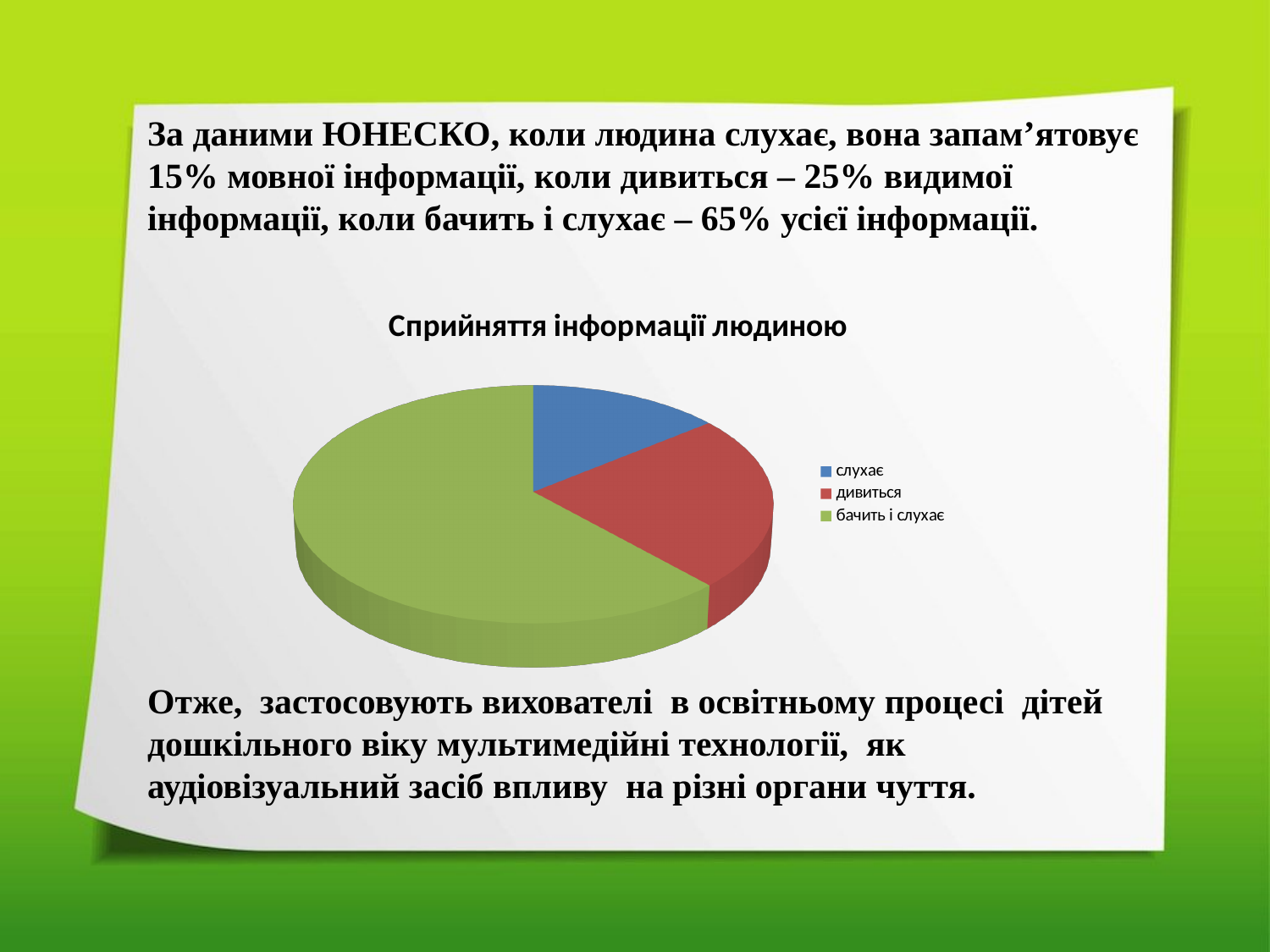
How many slices does the pie chart have? 3 What kind of chart is shown on the slide? pie chart What colour is the "слухає" slice in the pie chart? blue Which category has the smallest slice of the pie? слухає What is the title of the chart? Сприйняття інформації людиною How many entries does the chart legend list? 3 Which slice is larger, "дивиться" or "слухає"? дивиться Which category has the largest slice of the pie? бачить і слухає Which slice is larger, "бачить і слухає" or "дивиться"? бачить і слухає